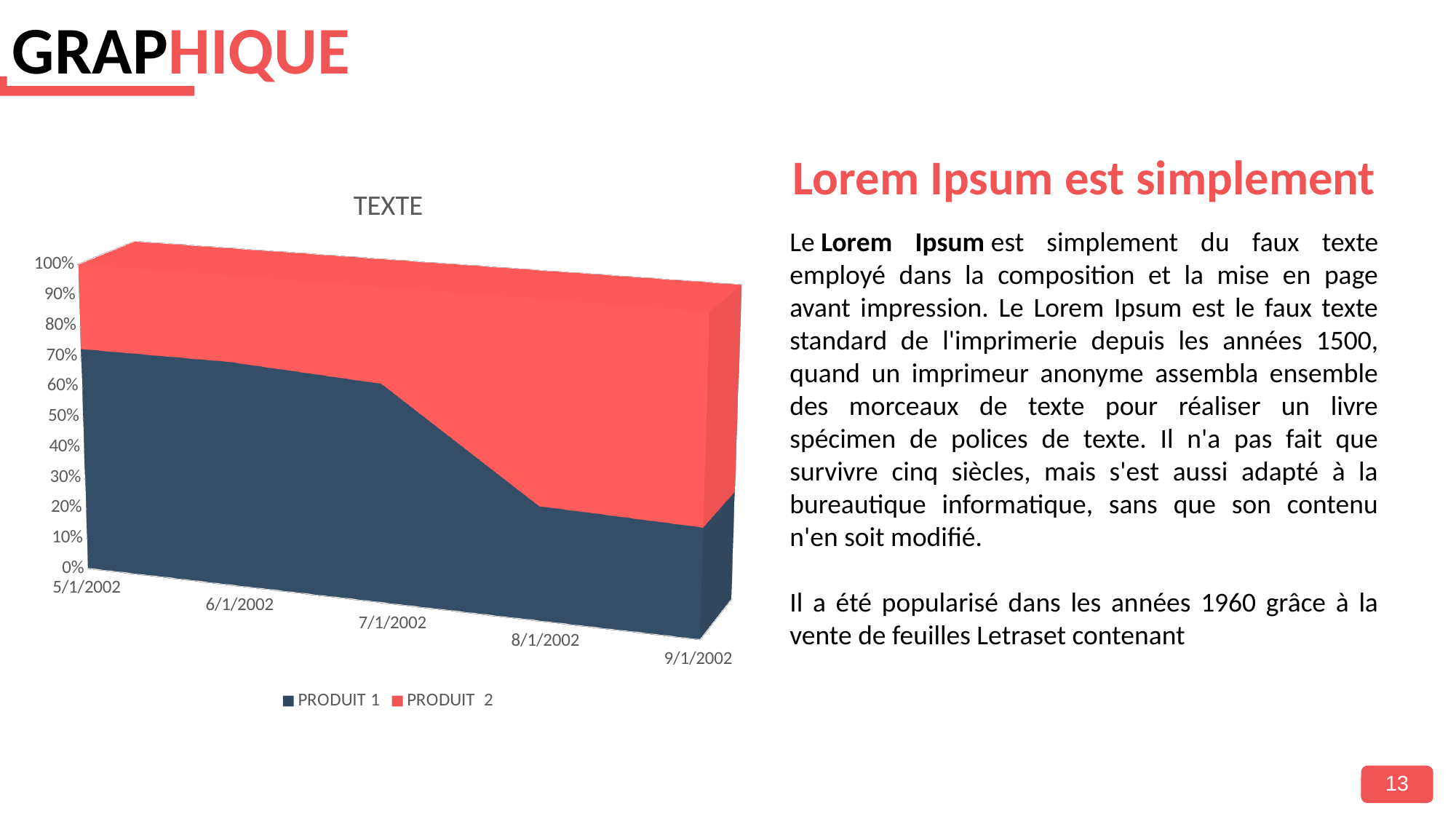
At 5/1/2002, which series has the larger share, PRODUIT 1 or PRODUIT 2? PRODUIT 1 What kind of chart is shown on the slide? Area chart Is the share of PRODUIT 1 at 5/1/2002 greater or less than 50%? greater What is the title of the chart? TEXTE How many dates are shown along the x axis of the chart? 5 Which colour represents PRODUIT 2 in the chart? Red At 9/1/2002, which series has the larger share, PRODUIT 1 or PRODUIT 2? PRODUIT 2 Does the share of PRODUIT 1 rise or fall from 5/1/2002 to 9/1/2002? Fall How many series does the chart legend list? 2 Is the share of PRODUIT 1 at 9/1/2002 greater or less than 50%? less Is the share of PRODUIT 1 at 8/1/2002 greater or less than 50%? less Is the share of PRODUIT 1 larger at 5/1/2002 or at 8/1/2002? 5/1/2002